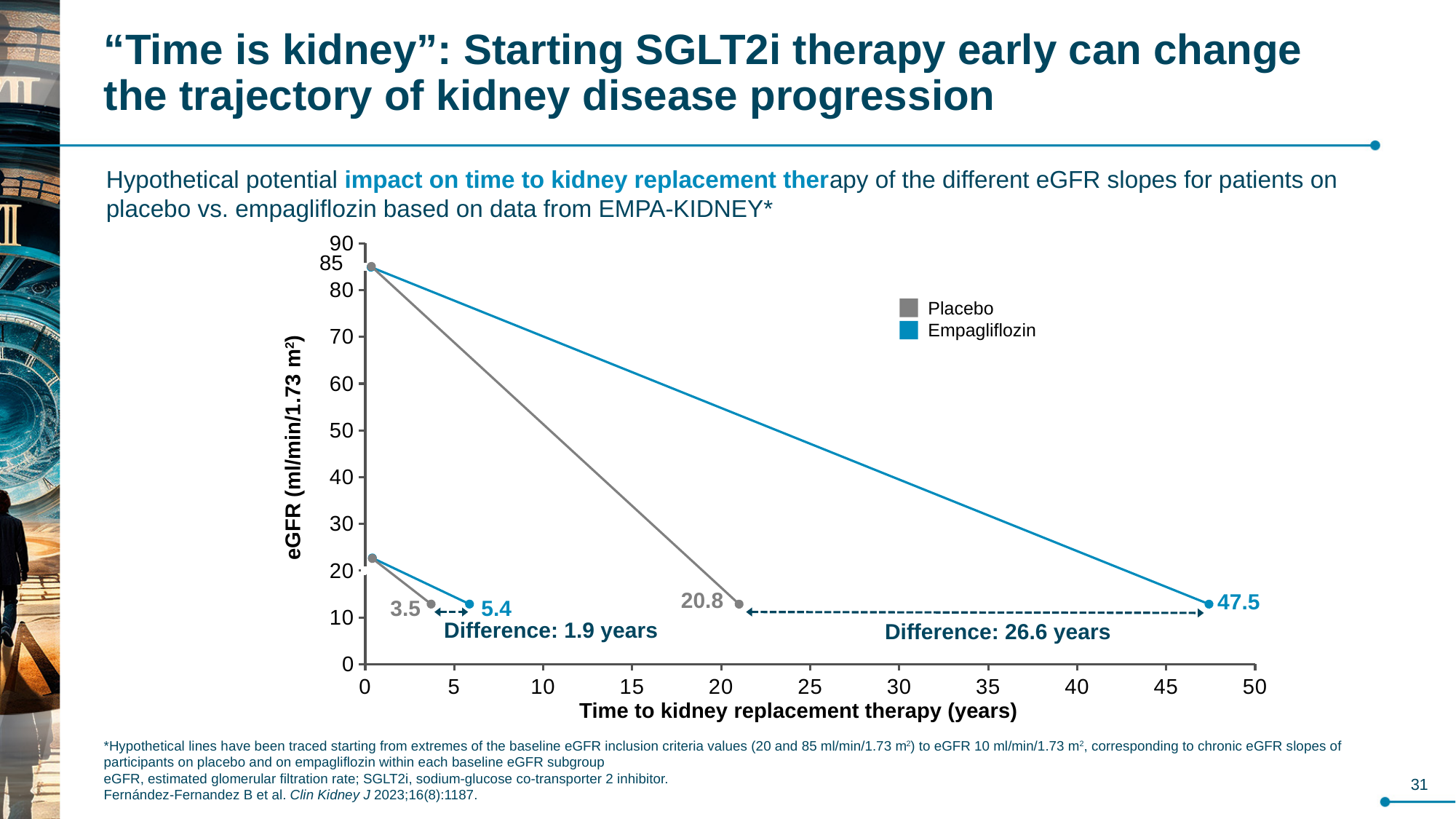
Which is larger: the time to kidney replacement therapy for placebo (20.8) or empagliflozin (47.5) starting from an eGFR of 85? Empagliflozin (47.5) What is the labelled time to kidney replacement therapy for the empagliflozin line starting from the lower baseline eGFR? 5.4 What type of chart is shown on the slide? line chart What is the labelled time to kidney replacement therapy for the placebo line starting from an eGFR of 85? 20.8 Which two series are listed in the chart legend? Placebo and Empagliflozin What is the labelled time to kidney replacement therapy for the empagliflozin line starting from an eGFR of 85? 47.5 What difference in years is annotated between the placebo and empagliflozin lines starting from the lower baseline eGFR? 1.9 years What is the label of the x axis of the chart? Time to kidney replacement therapy (years) How many series does the chart legend list? 2 What difference in years is annotated between the placebo and empagliflozin lines starting from an eGFR of 85? 26.6 years What is the labelled time to kidney replacement therapy for the placebo line starting from the lower baseline eGFR? 3.5 Which labelled endpoint has the largest time to kidney replacement therapy? 47.5